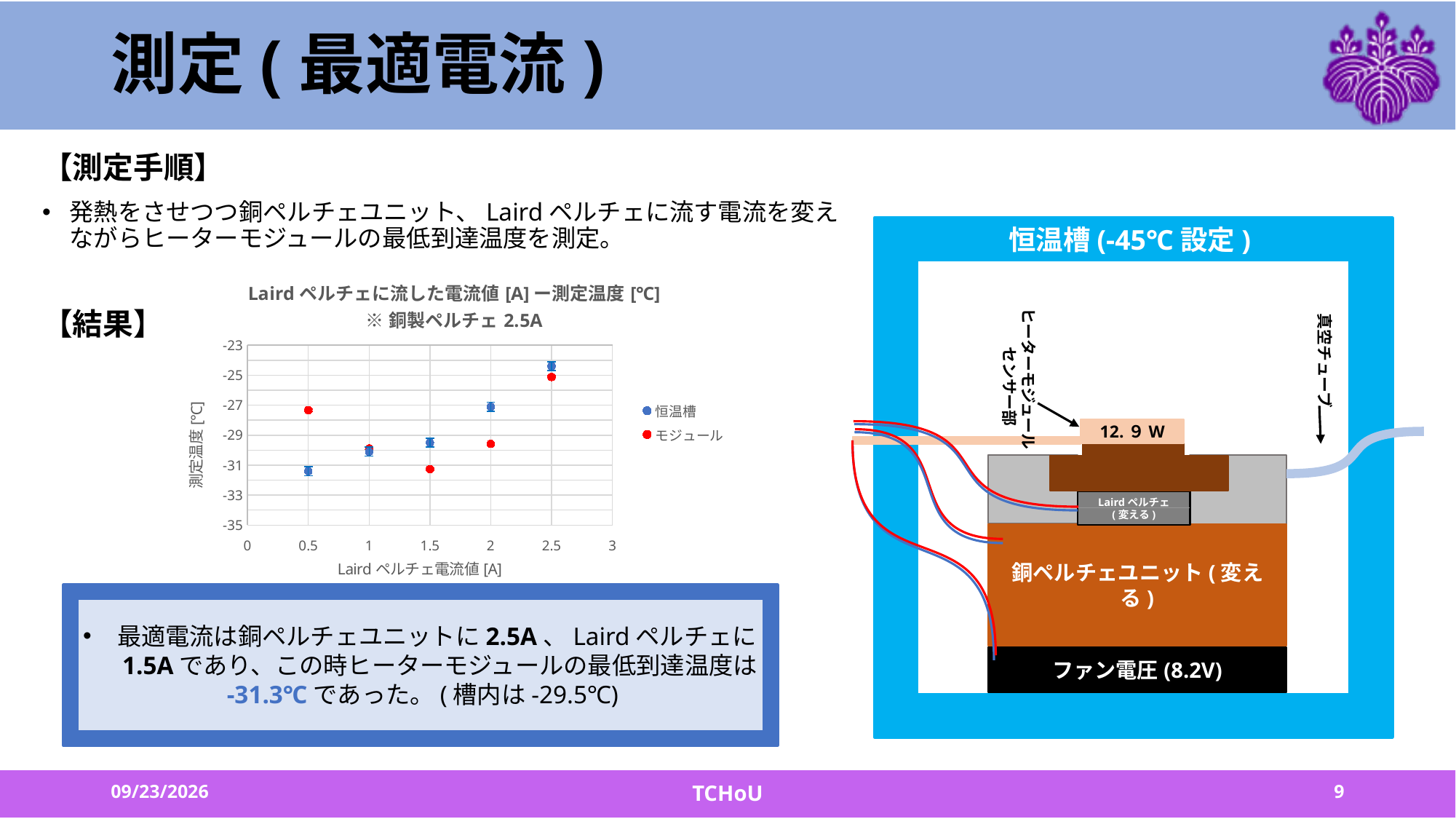
What is the label of the x axis of the chart? Laird ペルチェ電流値 [A] At which Laird Peltier current does the モジュール series reach its highest temperature? 2.5 A How many current values (data points per series) are plotted in the chart? 5 What kind of chart is shown on the slide? scatter chart Is the 恒温槽 value at 2.5 A greater or less than -27? greater Is the モジュール value at 0.5 A greater or less than -29? greater At which Laird Peltier current is the 恒温槽 series lowest? 0.5 A How many series does the chart legend list? 2 Does the 恒温槽 series rise or fall as the Laird Peltier current increases from 0.5 A to 2.5 A? rise At 0.5 A, which series shows the higher temperature, 恒温槽 or モジュール? モジュール Is the 恒温槽 value at 0.5 A greater or less than -29? less At which Laird Peltier current does the モジュール series reach its lowest temperature? 1.5 A